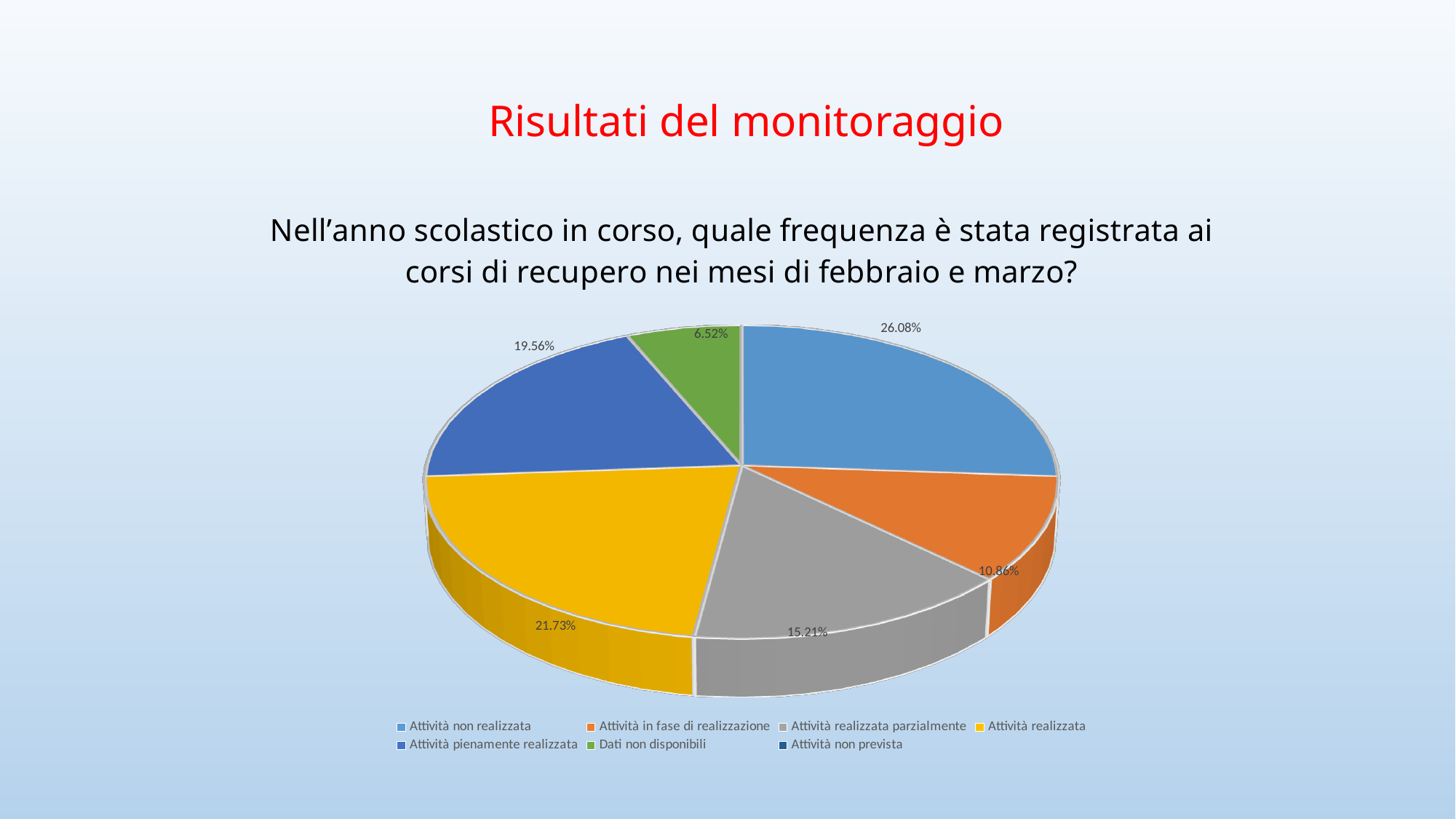
Which labelled slice is the smallest in the pie? Dati non disponibili Which is larger: the slice for "Attività realizzata" or the slice for "Attività pienamente realizzata"? Attività realizzata What is the title of the chart? Nell'anno scolastico in corso, quale frequenza è stata registrata ai corsi di recupero nei mesi di febbraio e marzo? What percentage is shown for "Attività realizzata"? 21.73% What kind of chart is shown on the slide? pie chart What percentage is shown for "Attività non realizzata"? 26.08% What percentage is shown for "Attività in fase di realizzazione"? 10.86% What is the difference between the percentages for "Attività non realizzata" and "Attività realizzata parzialmente"? 10.87% Which category has the largest slice of the pie? Attività non realizzata How many entries does the legend list? 7 What percentage is shown for "Dati non disponibili"? 6.52% What percentage is shown for "Attività pienamente realizzata"? 19.56%